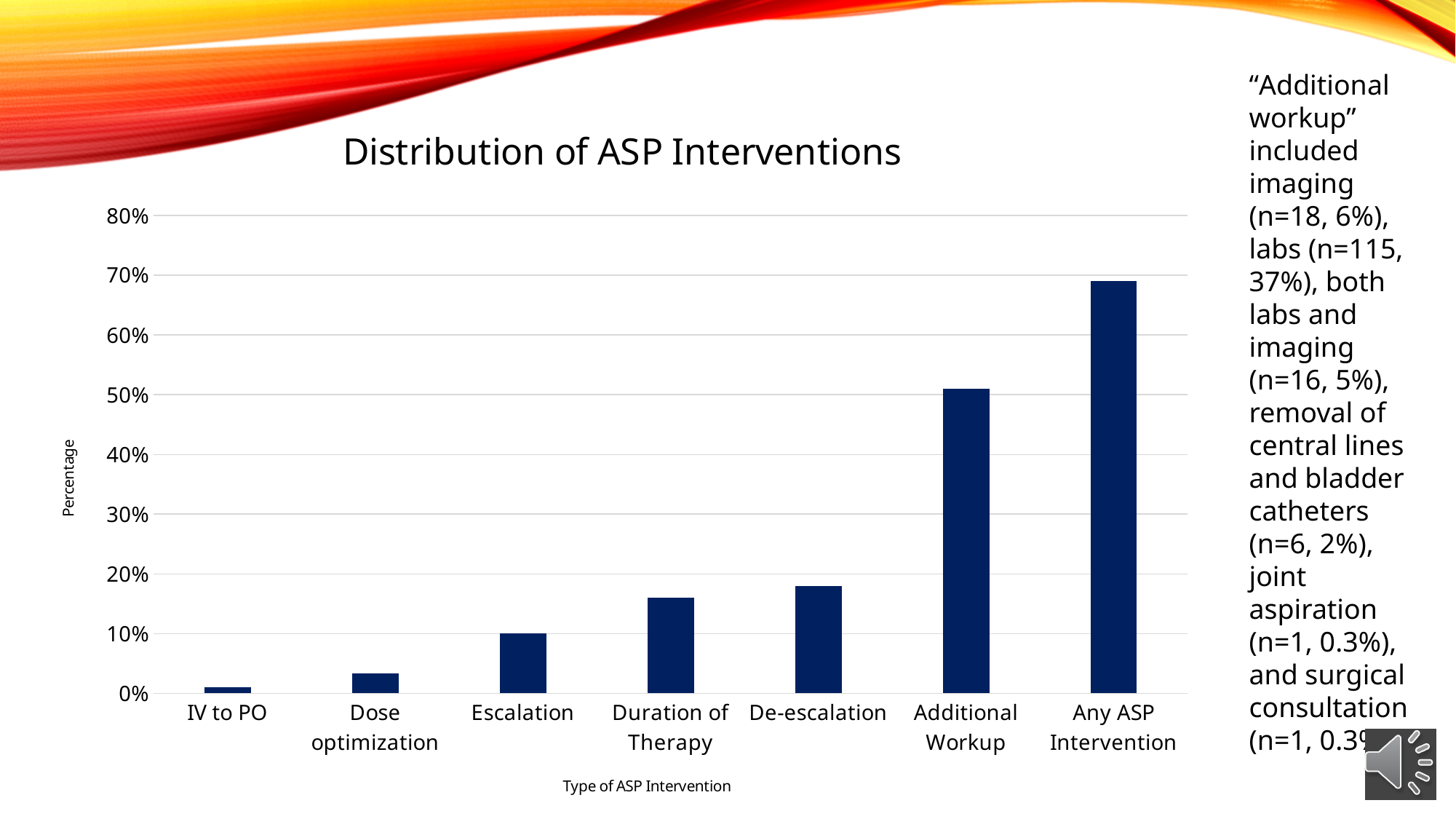
What type of chart is shown on the slide? bar chart Is the value for Any ASP Intervention greater or less than 60%? greater Is the value for Dose optimization greater or less than 10%? less Which type of ASP intervention has the lowest percentage? IV to PO Do the bar values rise or fall moving from left to right along the x axis? rise How many types of ASP intervention are plotted on the x axis? 7 Is the value for De-escalation greater or less than 20%? less What is the title of the chart? Distribution of ASP Interventions Which type of ASP intervention has the highest percentage? Any ASP Intervention Which is larger, the percentage for Additional Workup or for Duration of Therapy? Additional Workup What is the label of the y axis? Percentage